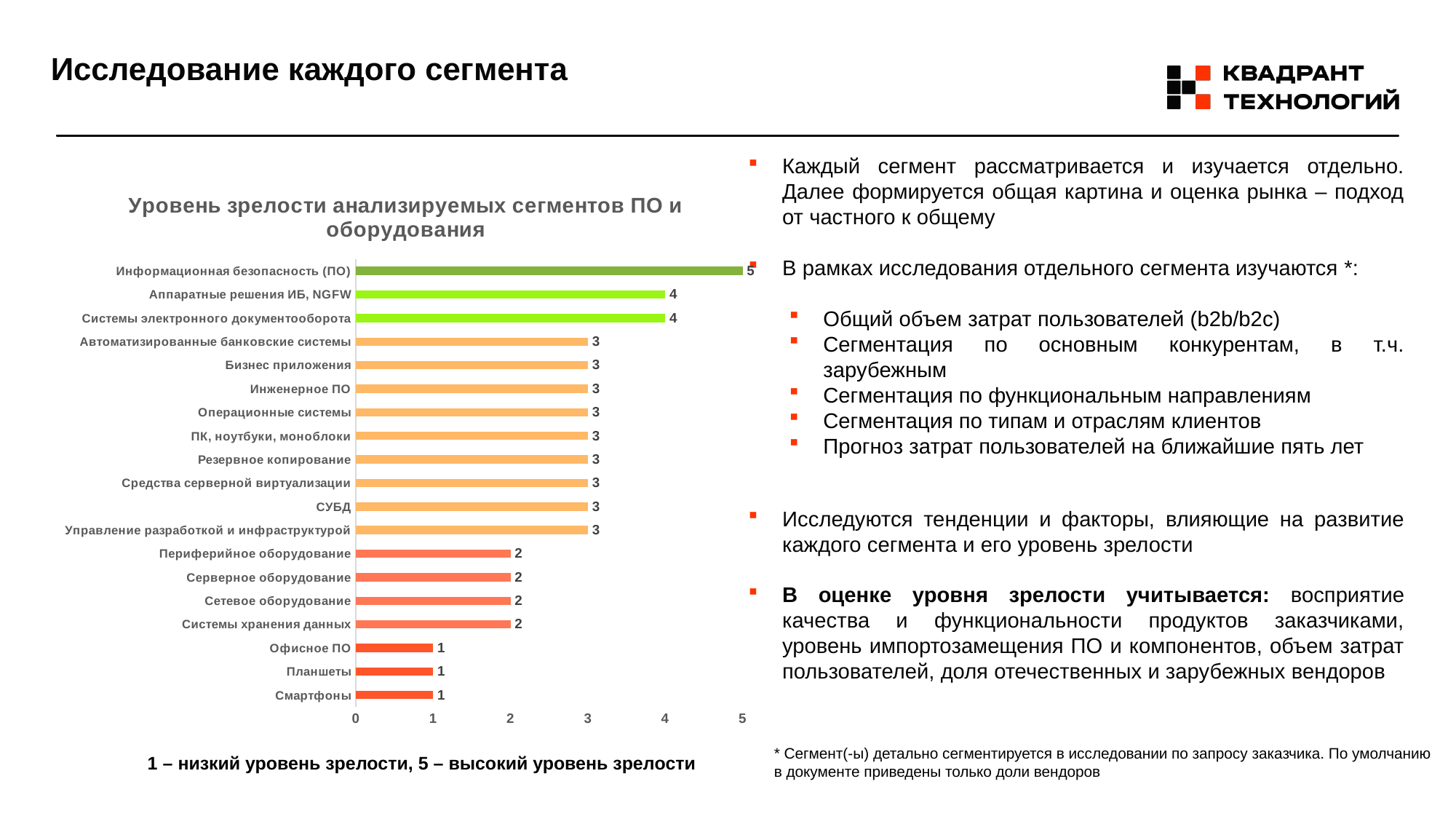
Which category has the highest maturity level? Информационная безопасность (ПО) What is the value for Серверное оборудование? 2 What is the value for Системы электронного документооборота? 4 What is the difference between the values for Информационная безопасность (ПО) and Офисное ПО? 4 What is the maturity level for Информационная безопасность (ПО)? 5 What is the title of the chart? Уровень зрелости анализируемых сегментов ПО и оборудования Which is larger, the value for СУБД or the value for Сетевое оборудование? СУБД What type of chart is shown on the slide? bar chart How many categories have a maturity level of 3? 9 How many categories are shown in the chart? 19 What is the difference between the values for Аппаратные решения ИБ, NGFW and Периферийное оборудование? 2 What is the value for Смартфоны? 1